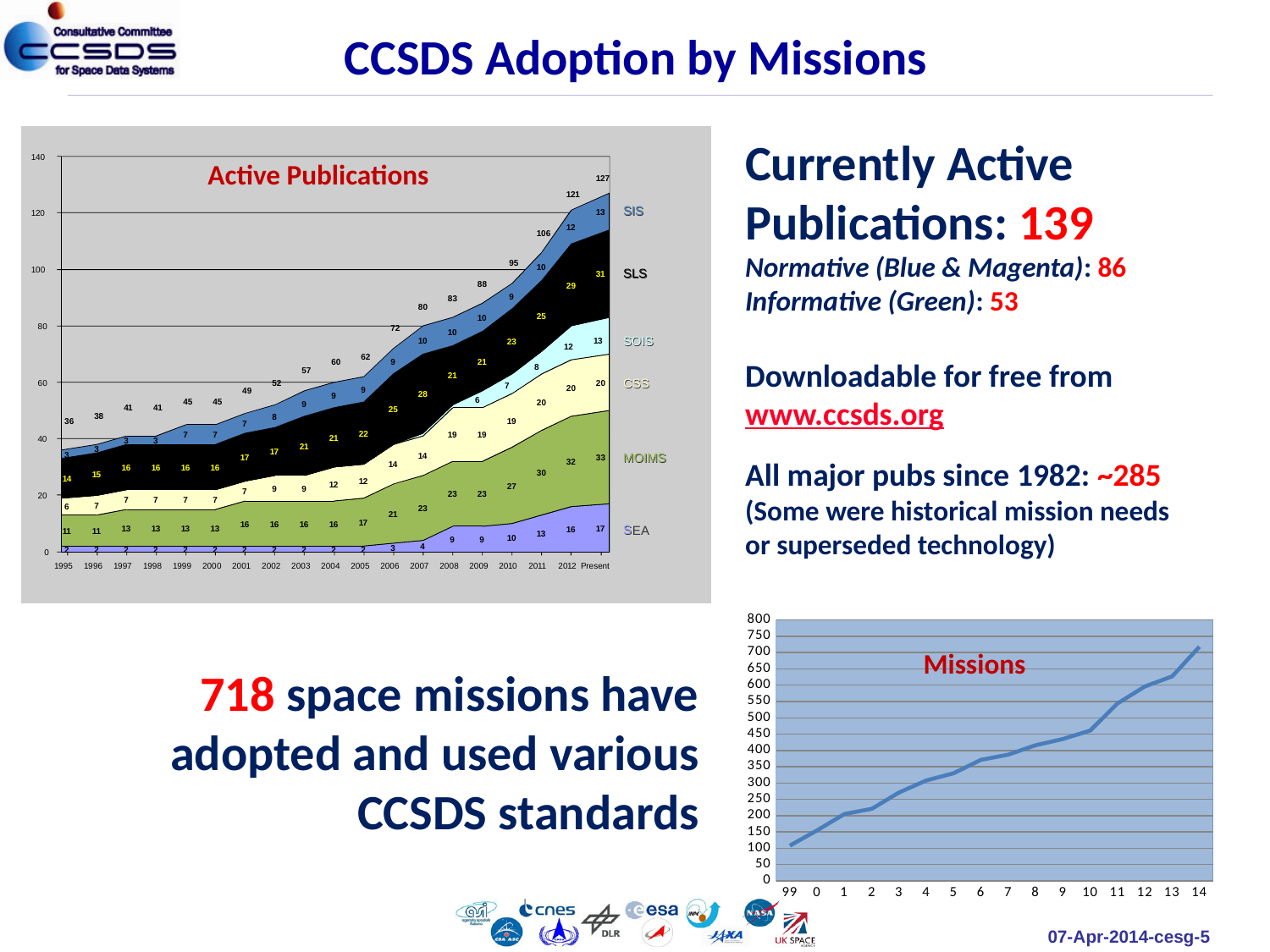
In the Active Publications chart, what is the SLS value at Present? 31 In the Active Publications chart, is the total for 2006 larger or smaller than the total for 2005? larger In the Active Publications chart, what is the difference between the total for Present and the total for 2012? 6 In the Active Publications chart, how many series are listed in the legend? 6 In the Active Publications chart, what is the total number of active publications shown for 1995? 36 What kind of chart is the Missions chart? line chart In the Active Publications chart, which year or period has the highest total of active publications? Present In the Active Publications chart, what is the total number of active publications shown for 2012? 121 In the Active Publications chart, what is the MOIMS value at Present? 33 In the Active Publications chart, which year has the lowest total of active publications? 1995 In the Missions chart, is the value at 14 greater or less than 650? greater In the Missions chart, do the values rise or fall along the x axis? rise